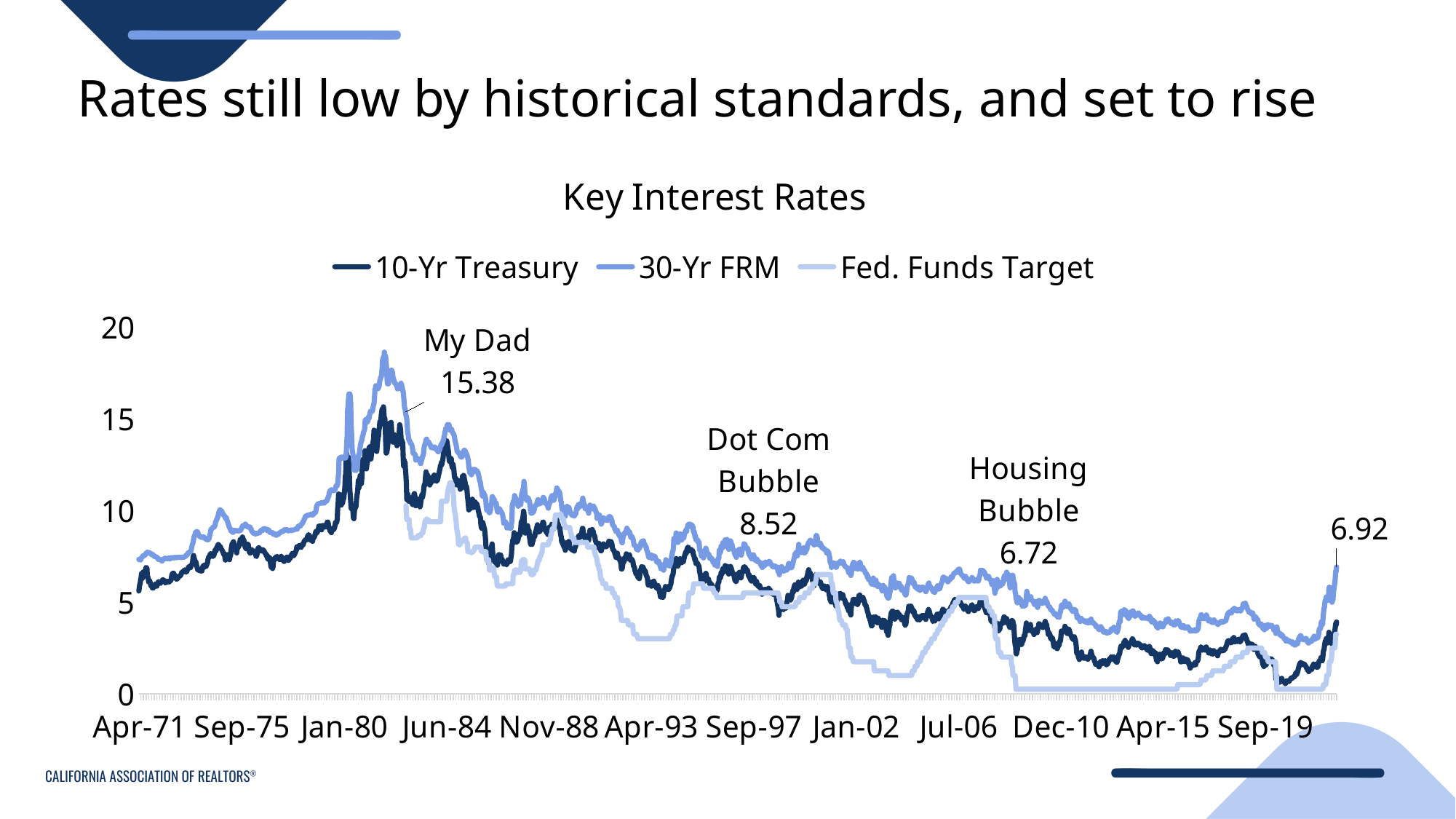
Which of the labelled points has the highest value? My Dad (15.38) What is the value labelled at the right-hand end of the chart? 6.92 What value is labelled at the point annotated 'Dot Com Bubble'? 8.52 What value is labelled at the point annotated 'Housing Bubble'? 6.72 What kind of chart is shown on the slide? Line chart What is the title of the chart? Key Interest Rates How many series does the chart's legend list? 3 Which series are listed in the chart's legend? 10-Yr Treasury, 30-Yr FRM, Fed. Funds Target What value is labelled at the point annotated 'My Dad'? 15.38 What is the difference between the 'My Dad' label value and the 'Dot Com Bubble' label value? 6.86 Is the Fed. Funds Target value around Dec-10 greater or less than 5? less Which is larger, the 'Dot Com Bubble' label value or the value labelled at the right-hand end of the chart? Dot Com Bubble (8.52)